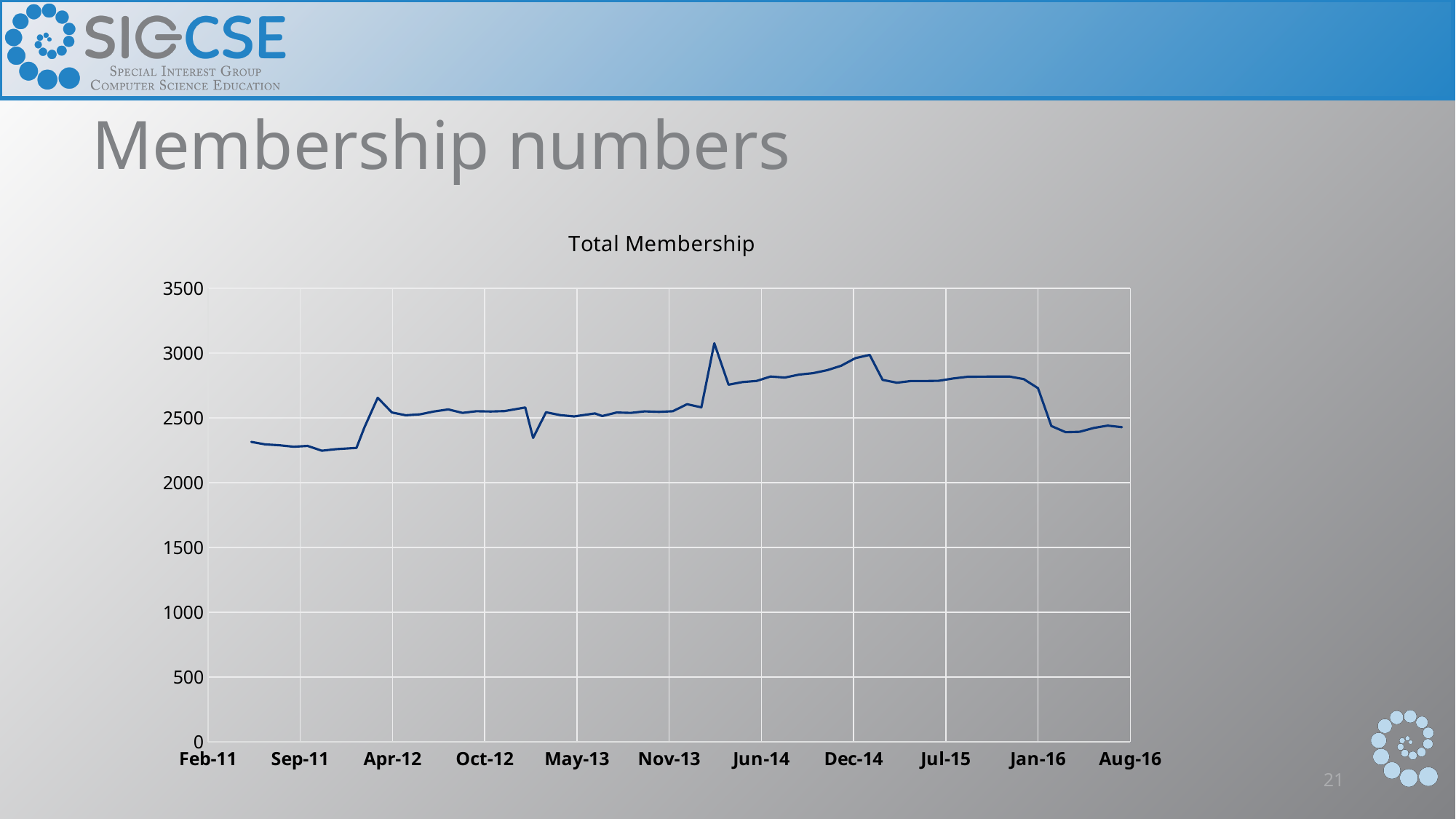
Is the value for Aug-16 greater or less than 2500? less Which has the larger value, Sep-11 or Jul-15? Jul-15 What is the title of the chart? Total Membership Is the highest point on the line greater or less than 3000? greater How many date labels are shown along the x axis of the chart? 11 Is the value for Jul-15 greater or less than 2500? greater Does the line rise or fall between Dec-14 and Aug-16? fall What is the highest value shown on the y axis? 3500 What kind of chart is shown on the slide? line chart Which has the larger value, Dec-14 or Aug-16? Dec-14